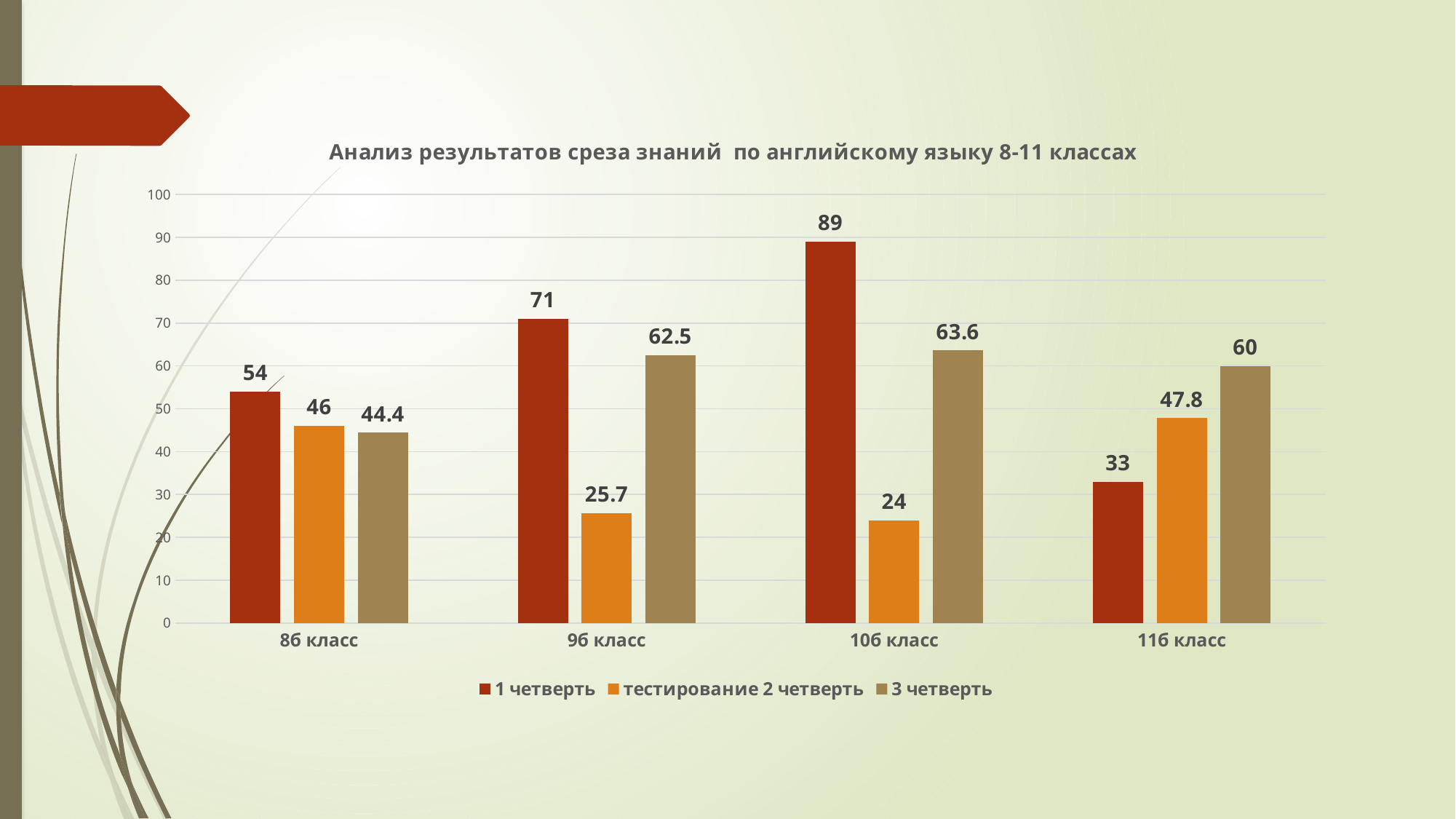
Is the value for 3 четверть in 8б класс greater or less than 50? less What is the value for тестирование 2 четверть in 9б класс? 25.7 What is the value for 3 четверть in 11б класс? 60 What is the title of the chart? Анализ результатов среза знаний по английскому языку 8-11 классах What kind of chart is shown on the slide? bar chart What is the value for 1 четверть in 10б класс? 89 How many classes are shown on the x axis? 4 What is the difference between the 1 четверть and 3 четверть values for 9б класс? 8.5 How many series does the legend list? 3 Which is larger for 11б класс: 1 четверть or тестирование 2 четверть? тестирование 2 четверть Which class has the highest value for 1 четверть? 10б класс Which class has the lowest value for тестирование 2 четверть? 10б класс